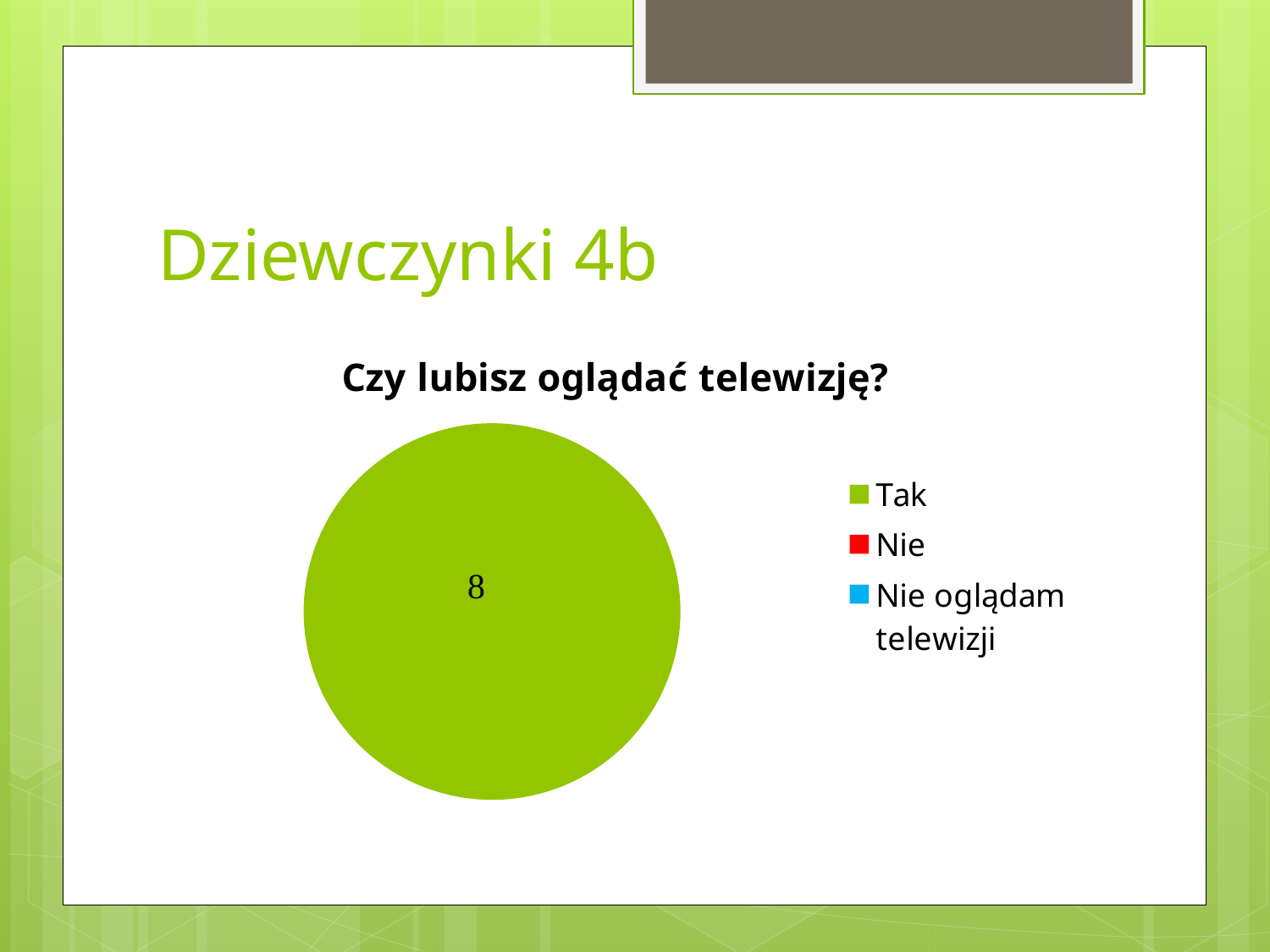
What value is printed on the pie slice for Tak? 8 What share of the pie does the Tak slice take up? 100% How many categories are listed in the chart's legend? 3 What kind of chart is shown on the slide? pie chart Which is larger, the value for Tak or the value for Nie? Tak How many entries does the legend list? 3 What is the title of the chart? Czy lubisz oglądać telewizję? What colour is the Tak slice of the pie? green Which category has the largest share of the pie? Tak